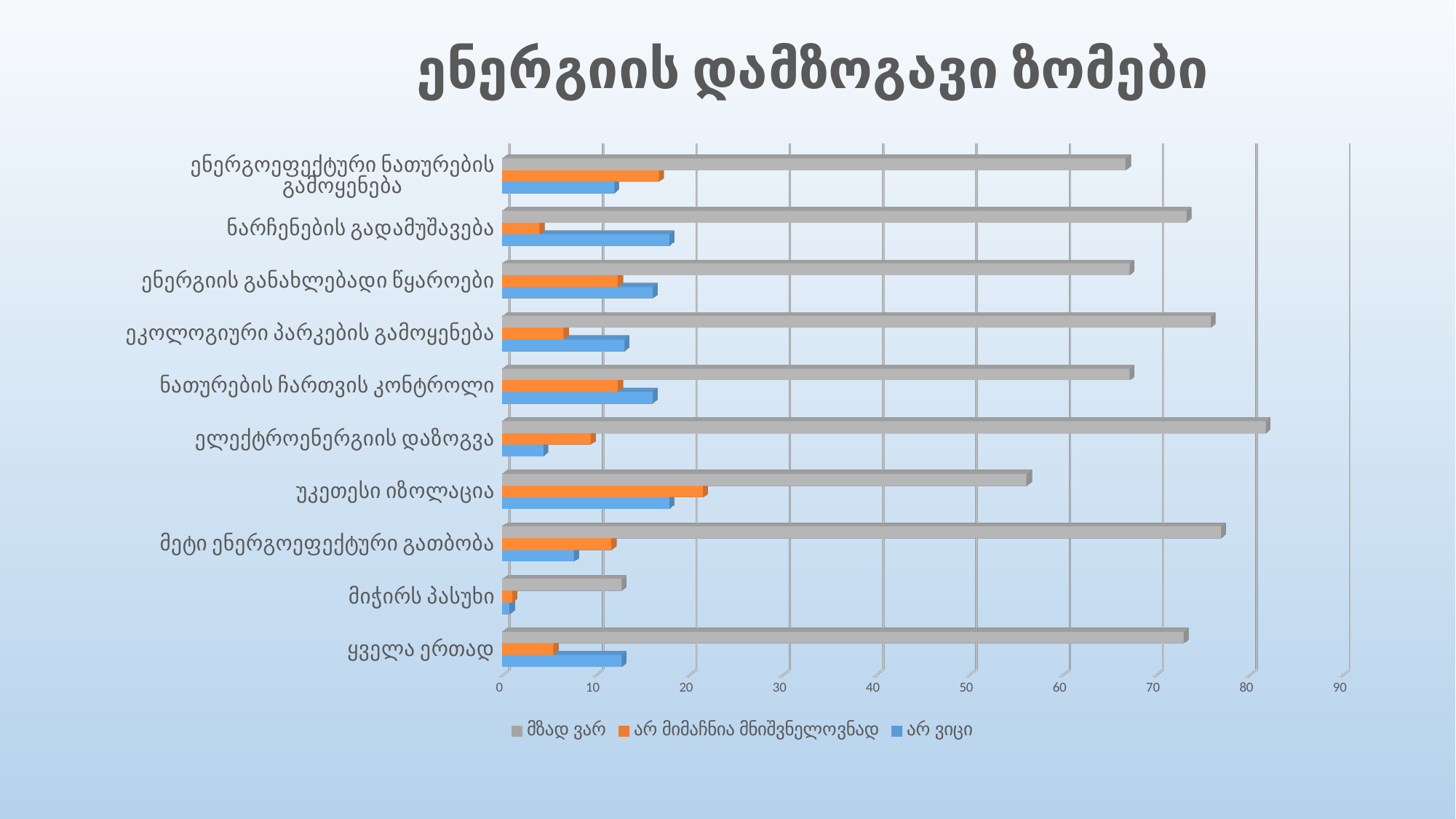
Which category has the lowest value for the series მზად ვარ? მიჭირს პასუხი What kind of chart is shown on the slide? bar chart What is the title of the chart? ენერგიის დამზოგავი ზომები For the series მზად ვარ, which is larger: უკეთესი იზოლაცია or მეტი ენერგოეფექტური გათბობა? მეტი ენერგოეფექტური გათბობა Is the value of არ მიმაჩნია მნიშვნელოვნად for უკეთესი იზოლაცია greater or less than 20? greater Which category has the highest value for the series მზად ვარ? ელექტროენერგიის დაზოგვა How many series does the legend list? 3 For ნარჩენების გადამუშავება, which series has the larger value: არ მიმაჩნია მნიშვნელოვნად or არ ვიცი? არ ვიცი Which category has the highest value for the series არ მიმაჩნია მნიშვნელოვნად? უკეთესი იზოლაცია Is the value of მზად ვარ for ელექტროენერგიის დაზოგვა greater or less than 80? greater How many categories are listed on the vertical axis of the chart? 10 Is the value of მზად ვარ for უკეთესი იზოლაცია greater or less than 60? less